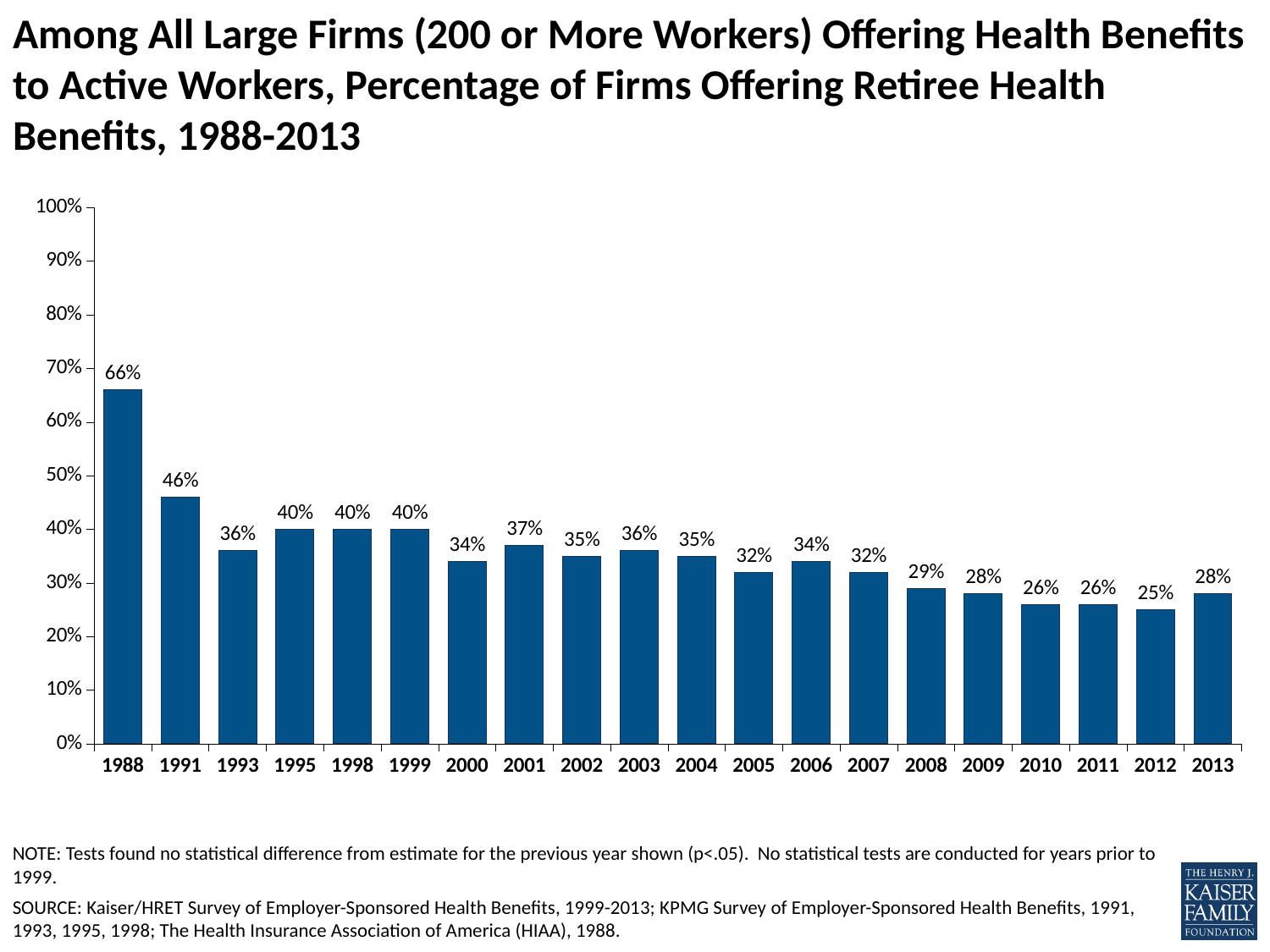
What percentage of large firms offered retiree health benefits in 1988? 66% What percentage is shown for 2013? 28% Overall, do the values rise or fall from 1988 to 2013? Fall Which year has a larger value, 2001 or 2005? 2001 Is the value for 2010 greater or less than 30%? less What is the difference between the 1988 value and the 1991 value? 20 percentage points Which year has the lowest percentage of firms offering retiree health benefits? 2012 What is the difference between the 2013 value and the 2012 value? 3 percentage points What is the value shown for 2012? 25% What kind of chart is shown on the slide? Bar chart Which year has the highest percentage of firms offering retiree health benefits? 1988 How many years are shown on the x axis? 20